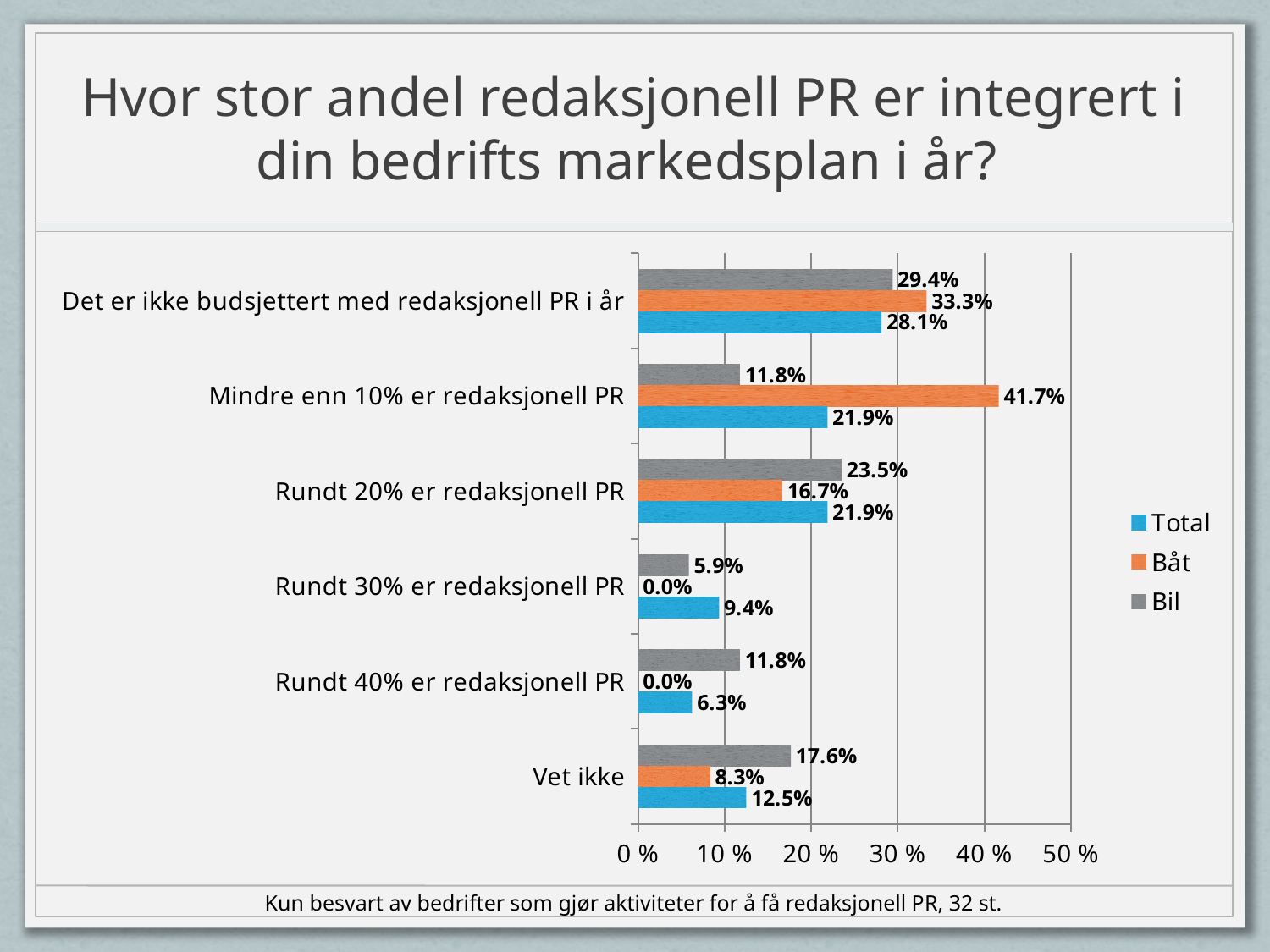
For "Rundt 20% er redaksjonell PR", which is larger: the Bil value or the Båt value? Bil How many series does the legend list? 3 What is the Båt value for "Mindre enn 10% er redaksjonell PR"? 41.7% Which colour represents the Båt series in the legend? Orange Which category has the lowest Total value? Rundt 40% er redaksjonell PR What is the difference between the Båt and Bil values for "Mindre enn 10% er redaksjonell PR"? 29.9% What is the Bil value for "Vet ikke"? 17.6% Which category has the highest Båt value? Mindre enn 10% er redaksjonell PR How many categories are shown on the chart? 6 What kind of chart is shown on the slide? Bar chart What is the Total value for "Det er ikke budsjettert med redaksjonell PR i år"? 28.1% What is the Båt value for "Rundt 30% er redaksjonell PR"? 0.0%